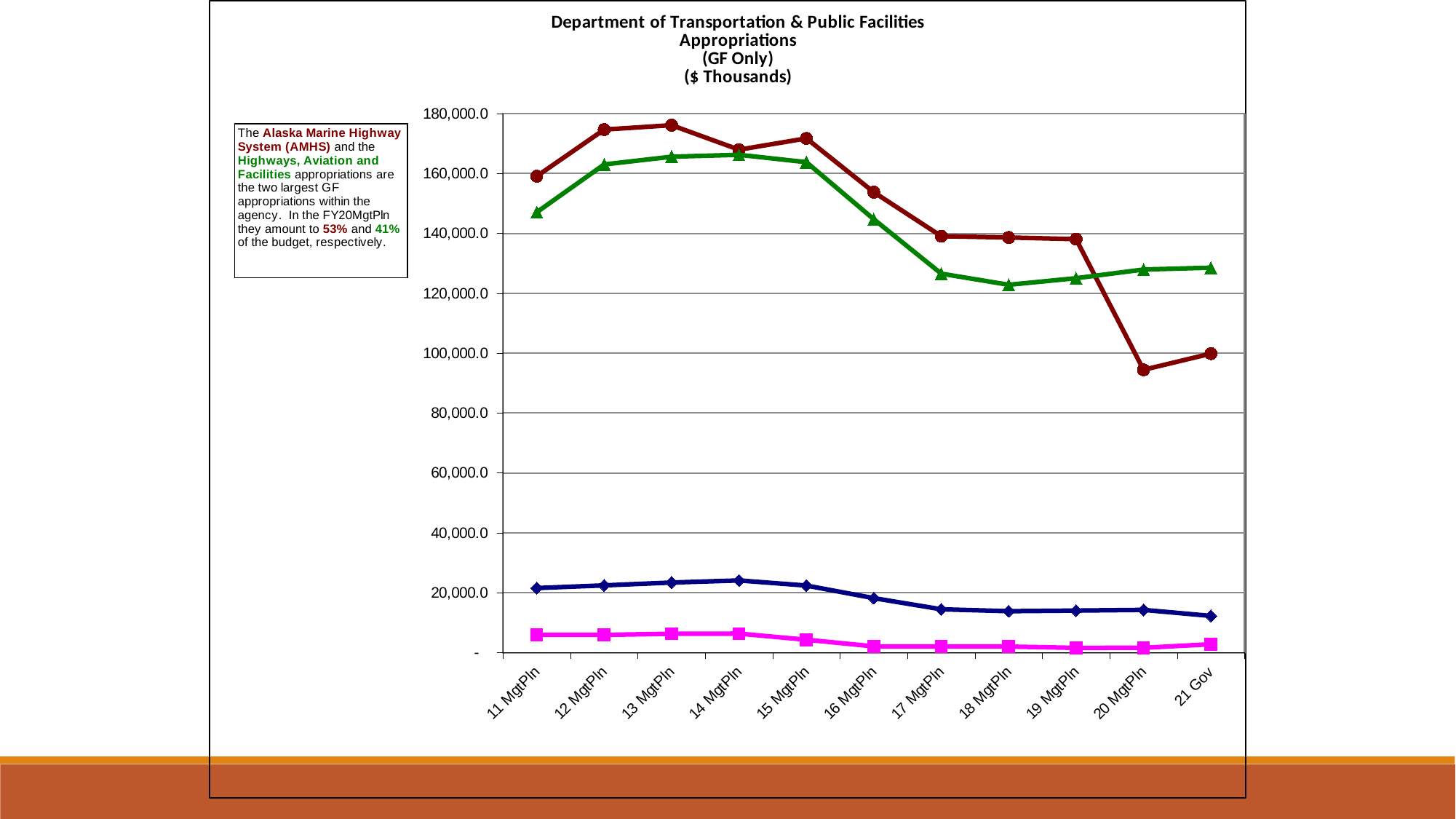
Is the value of the dark blue line at 21 Gov greater or less than 20,000.0? less How many lines are plotted on the chart? 4 At 21 Gov, which is larger: the dark red (AMHS) line or the green (Highways, Aviation and Facilities) line? green (Highways, Aviation and Facilities) What is the title of the chart? Department of Transportation & Public Facilities Appropriations (GF Only) ($ Thousands) Is the value of the dark red (AMHS) line at 20 MgtPln greater or less than 100,000.0? less Is the value of the green (Highways, Aviation and Facilities) line at 21 Gov greater or less than 120,000.0? greater Does the dark red (AMHS) line rise or fall from 15 MgtPln to 20 MgtPln? fall How many fiscal-year categories are shown along the x axis? 11 What kind of chart is shown on the slide? line chart At 11 MgtPln, which is larger: the dark red (AMHS) line or the green (Highways, Aviation and Facilities) line? dark red (AMHS) At which x-axis category does the dark red (AMHS) line reach its lowest value? 20 MgtPln